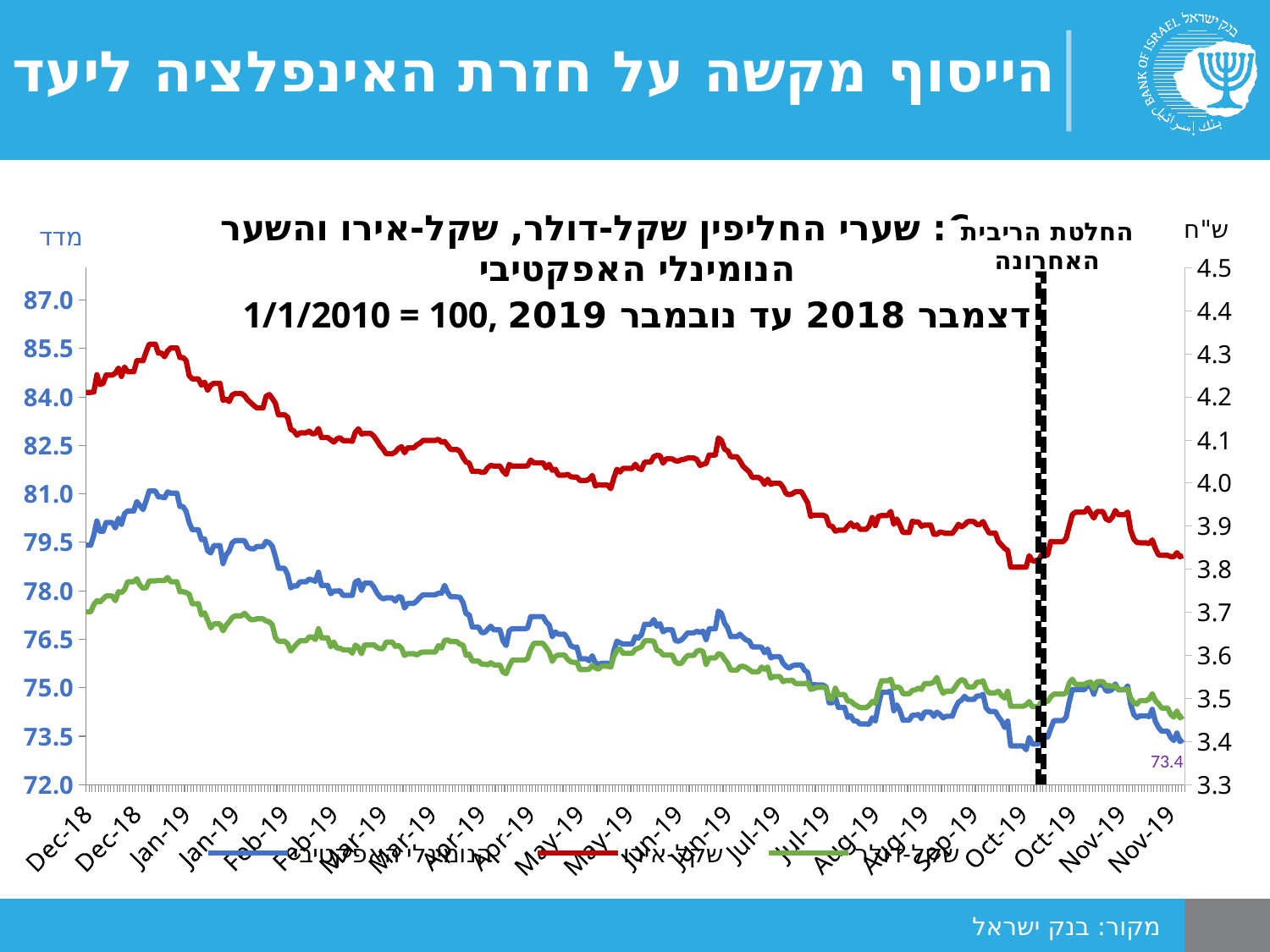
Is the green line's value at the start of the period (Dec-18) greater or less than 3.6 on the right-hand axis? greater What kind of chart is shown on the slide? line chart Is the red line's value at the start of the period (Dec-18) greater or less than 4.0 on the right-hand axis? greater What is the label of the left-hand vertical axis? מדד At Nov-19, which is higher on the right-hand axis: the red line or the green line? the red line How many lines (series) are plotted on the chart? 3 Does the blue line rise or fall overall from Dec-18 to Nov-19? fall What is the value printed at the end of the blue line (Nov-19)? 73.4 Is the blue line's value at the start of the period (Dec-18) greater or less than 78.0 on the left-hand axis? greater Which line is the highest on the chart throughout the period? the red line Does the red line rise or fall overall from Dec-18 to Nov-19? fall What does the label on the vertical dashed line say? החלטת הריבית האחרונה